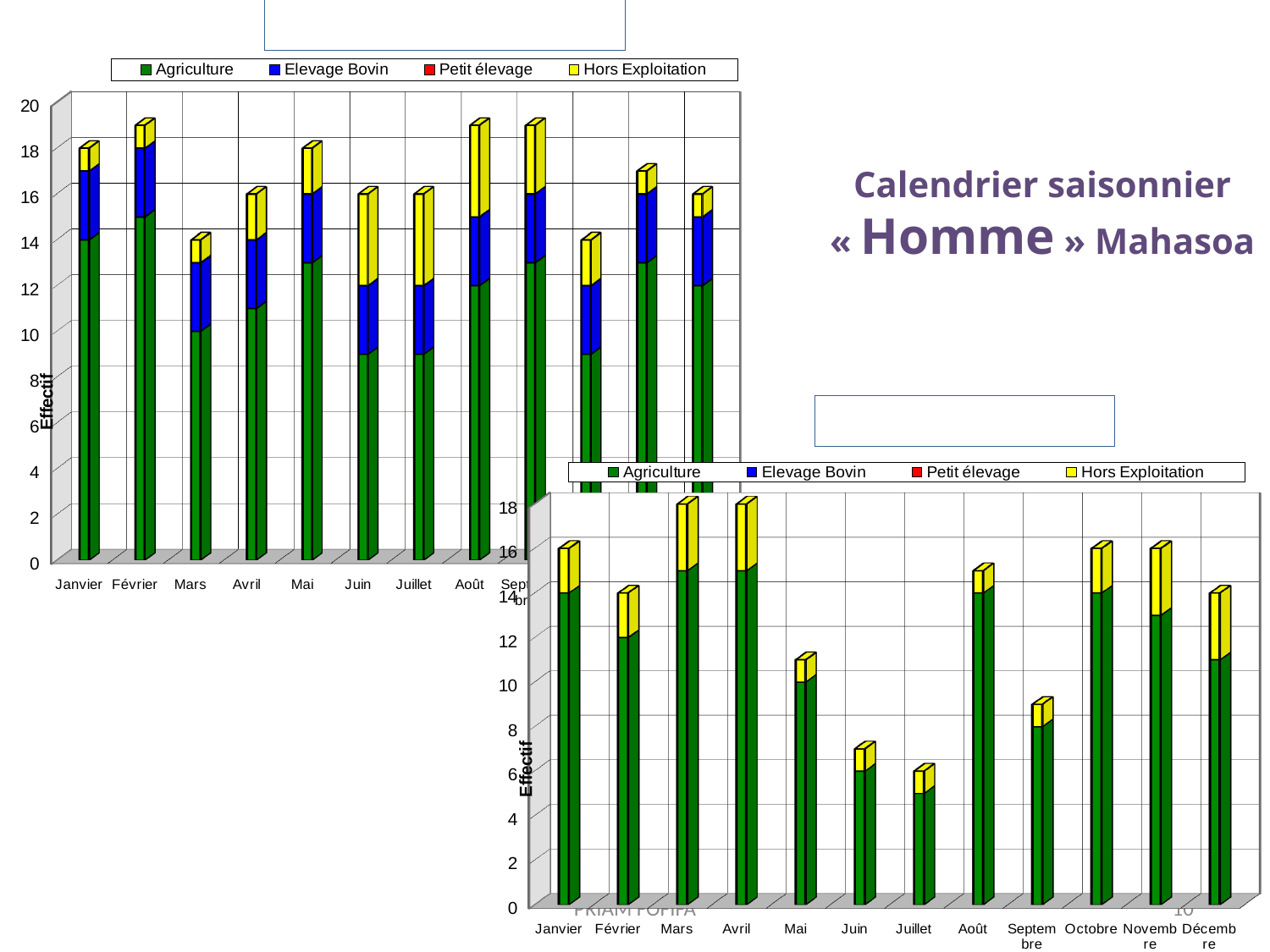
How many series does the legend of the bottom-right chart list? 4 In the bottom-right chart, which month has the lowest total bar? Juillet In the top-left chart, is the total bar for Mars greater or less than 16? less In the bottom-right chart, is the total bar for Mars greater or less than 16? greater What kind of chart is the chart in the top-left of the slide? stacked bar chart In the top-left chart, which month has the larger total bar, Février or Mars? Février Which series is shown in green in the legend of the top-left chart? Agriculture How many months are shown on the x axis of the bottom-right chart? 12 What is the label of the y axis on the bottom-right chart? Effectif In the top-left chart, is the total bar for Janvier greater or less than 16? greater In the bottom-right chart, which month has the larger total bar, Mai or Juin? Mai